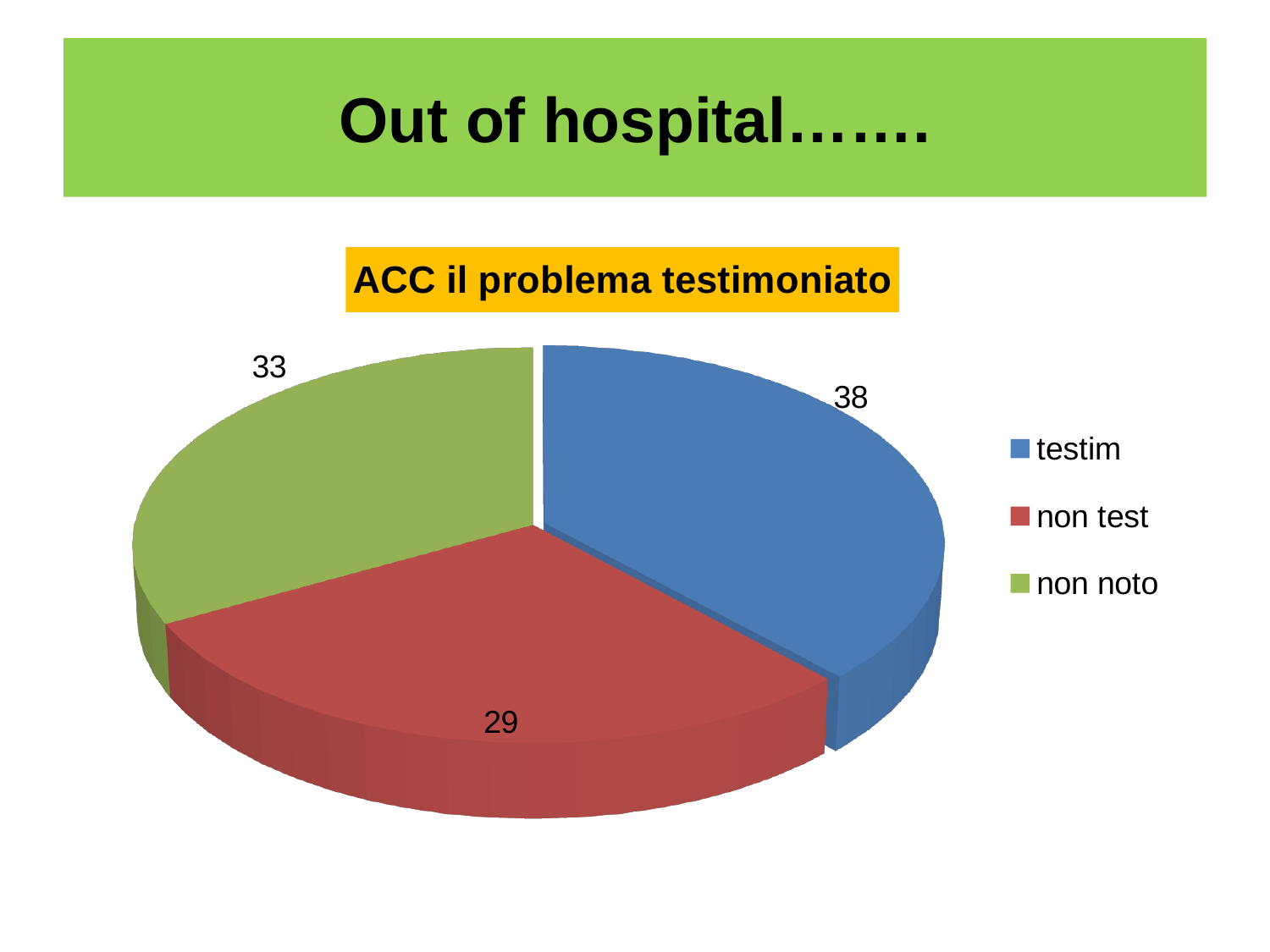
What is the value for non test? 29 What is the value for testim? 38 What is the difference between the values for non noto and non test? 4 What is the value for non noto? 33 What is the difference between the values for testim and non test? 9 How many categories does the pie chart show? 3 Which category has the lowest value? non test What kind of chart is shown on the slide? pie chart Which is larger, the value for testim or the value for non noto? testim What colour is the slice for non test? red What is the title of the chart? ACC il problema testimoniato Which category has the highest value? testim